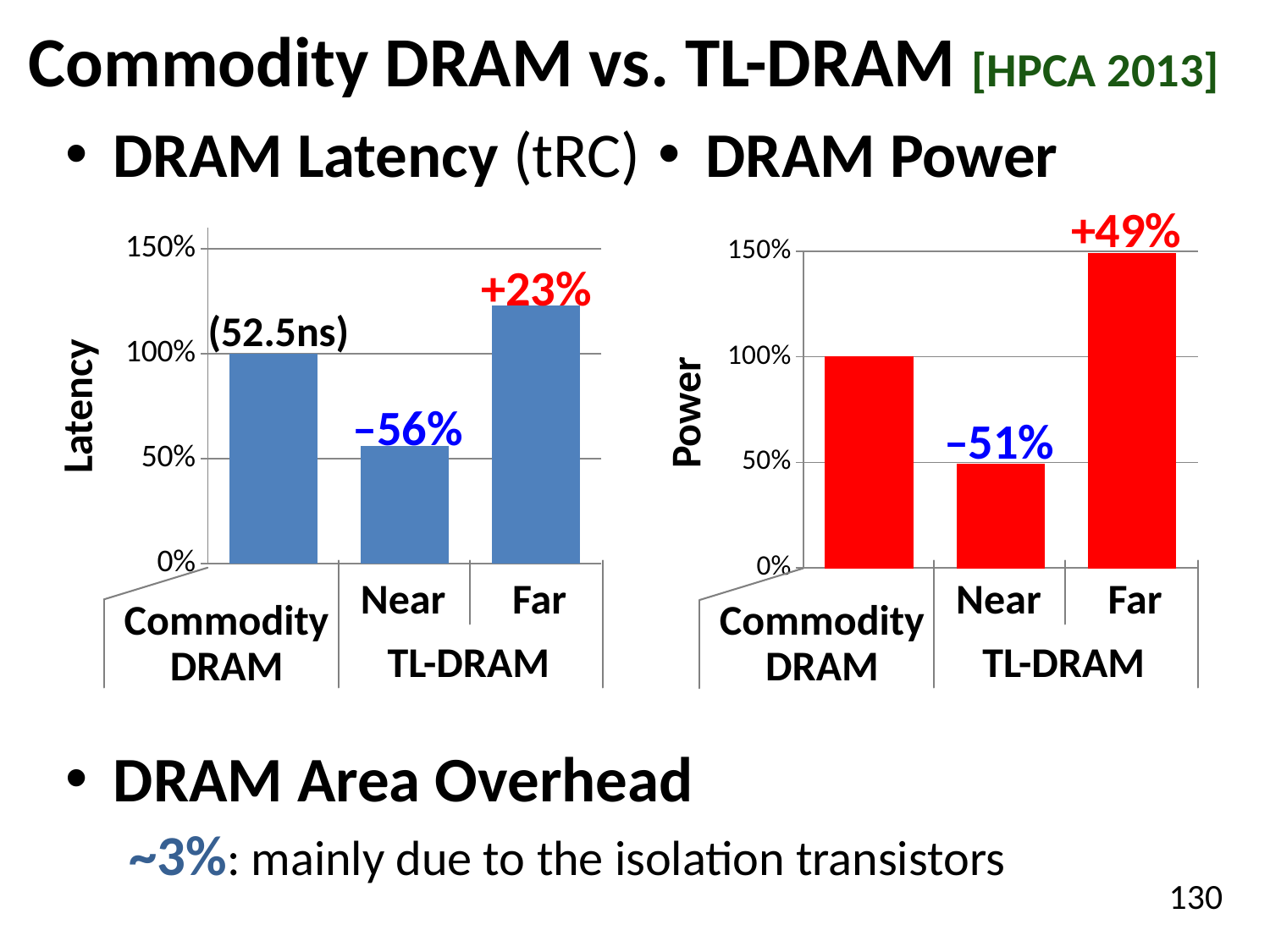
In the DRAM Power chart, which bar is the highest? Far In the DRAM Power chart, what is the value for Commodity DRAM? 100% In the DRAM Latency chart, what absolute latency is printed next to the Commodity DRAM bar? (52.5ns) In the DRAM Power chart, what change label is printed above the Far bar? +49% In the DRAM Latency chart, is the value for Near greater or less than 50%? greater In the DRAM Latency chart, what change label is printed above the Far bar? +23% In the DRAM Latency chart, how many bars are plotted? 3 In the DRAM Latency chart, what change label is printed above the Near bar? –56% In the DRAM Latency chart, what is the value for Commodity DRAM? 100% In the DRAM Latency chart, which bar is the lowest? Near In the DRAM Power chart, is the value for Far greater or less than 100%? greater What kind of chart is the DRAM Latency chart on the left? bar chart